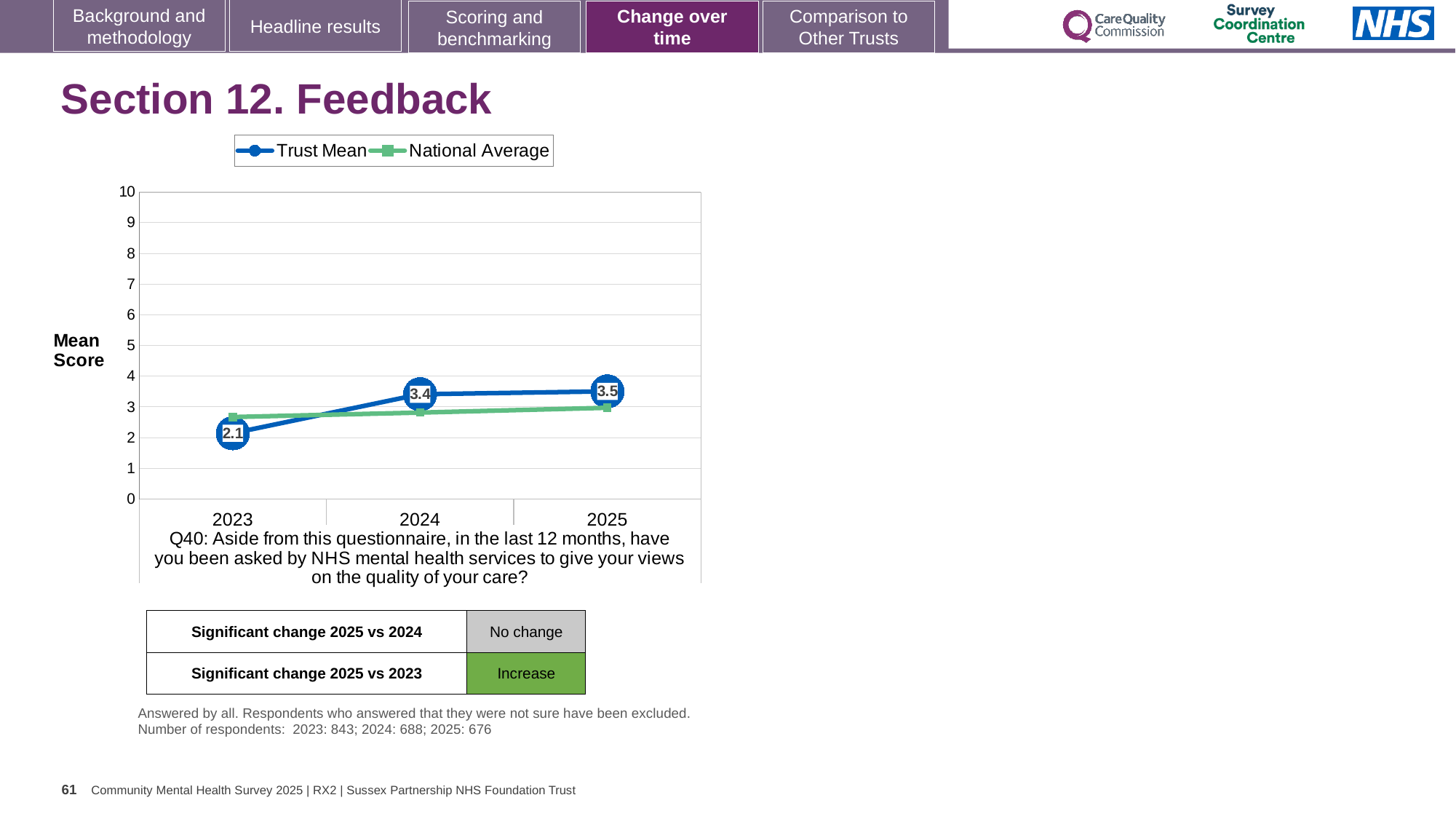
What is the Trust Mean score for 2023? 2.1 How many years are shown on the x axis of the chart? 3 In which year is the Trust Mean score lowest? 2023 What is the Trust Mean score for 2025? 3.5 Which is higher in 2023, the Trust Mean or the National Average? National Average What is the Trust Mean score for 2024? 3.4 What is the difference between the Trust Mean scores for 2025 and 2023? 1.4 What kind of chart is shown on the slide? Line chart Is the National Average value for 2024 greater or less than 4? less Is the National Average value for 2023 greater or less than 2? greater How many series does the chart legend list? 2 Which is higher in 2025, the Trust Mean or the National Average? Trust Mean